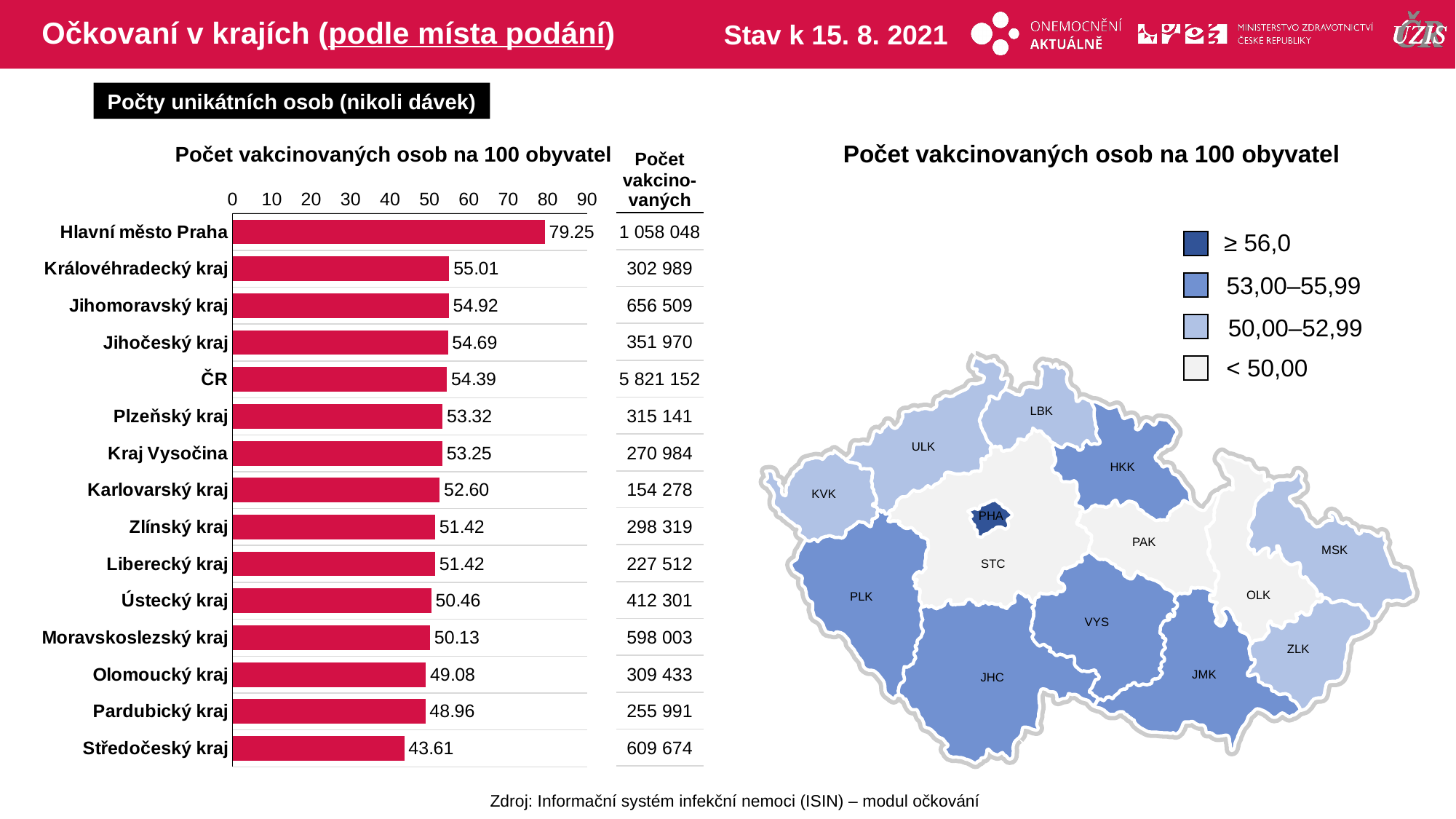
In the bar chart, is the value for Pardubický kraj greater or less than 50? less In the 'Počet vakcinovaných' column next to the bar chart, what is the number for Jihomoravský kraj? 656 509 How many colour categories does the legend of the map on the right list? 4 In the bar chart 'Počet vakcinovaných osob na 100 obyvatel', what is the value for Hlavní město Praha? 79.25 Which region has the highest value in the bar chart? Hlavní město Praha What kind of chart is shown on the left side of the slide? bar chart In the bar chart, which has a larger value: Karlovarský kraj or Olomoucký kraj? Karlovarský kraj In the bar chart, what is the value for ČR? 54.39 What is the difference between the values for Hlavní město Praha and Středočeský kraj in the bar chart? 35.64 In the bar chart, what is the value for Kraj Vysočina? 53.25 Which region has the lowest value in the bar chart? Středočeský kraj How many bars (categories) are shown in the bar chart? 15